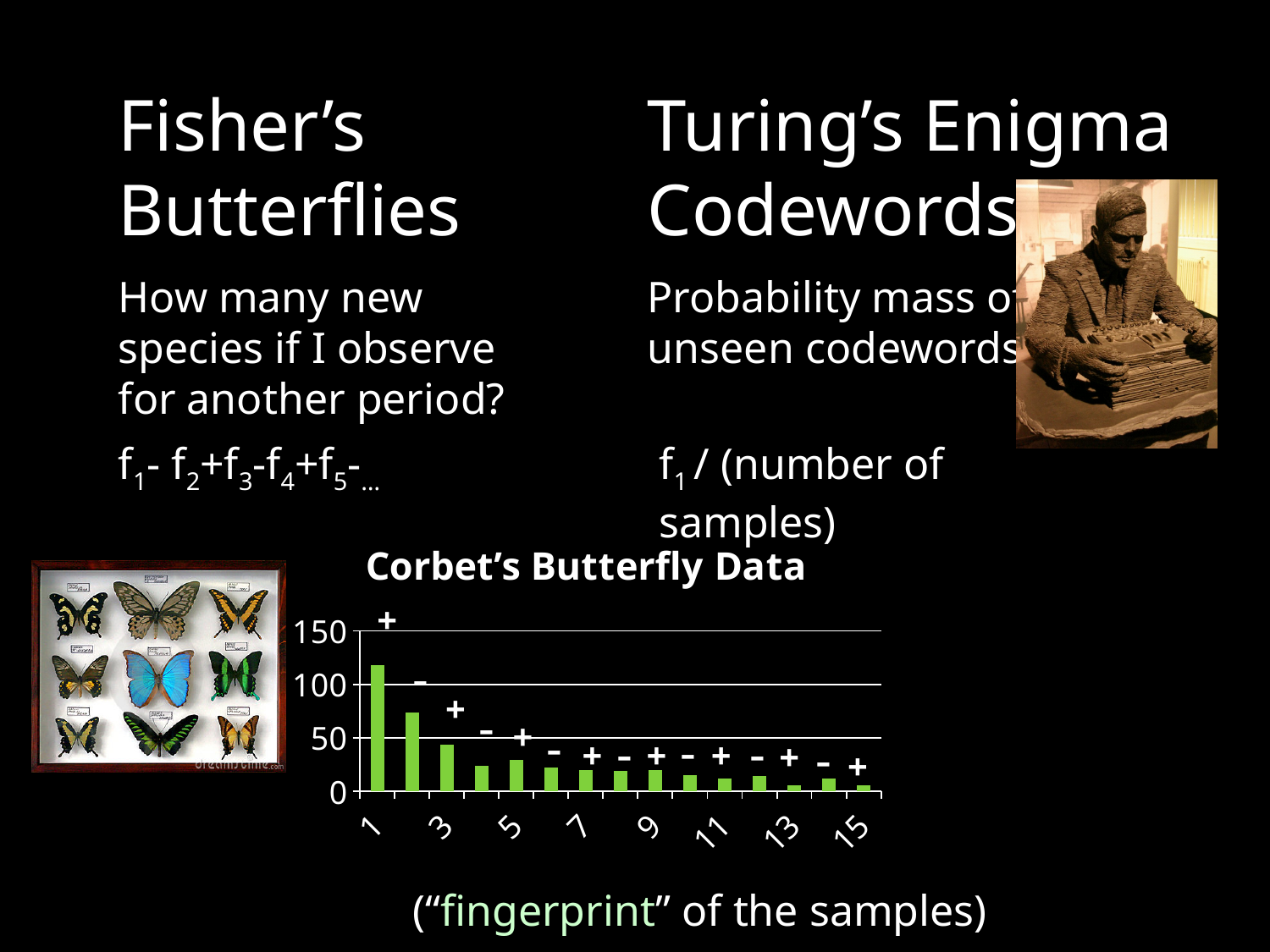
Is the value for category 3 greater or less than 50? less What kind of chart is shown under the title "Corbet's Butterfly Data"? bar chart Is the value for category 1 greater or less than 100? greater Which category has the highest bar in the Corbet's Butterfly Data chart? 1 What symbol is printed above the bar for category 1 in the chart? + What is the title of the chart on the slide? Corbet's Butterfly Data How many bars (categories) are plotted in the Corbet's Butterfly Data chart? 15 Is the value for category 2 greater or less than 100? less Which is larger, the value for category 1 or the value for category 2? category 1 Do the bar values generally rise or fall as the category number increases from 1 to 15? fall Which is larger, the value for category 3 or the value for category 5? category 3